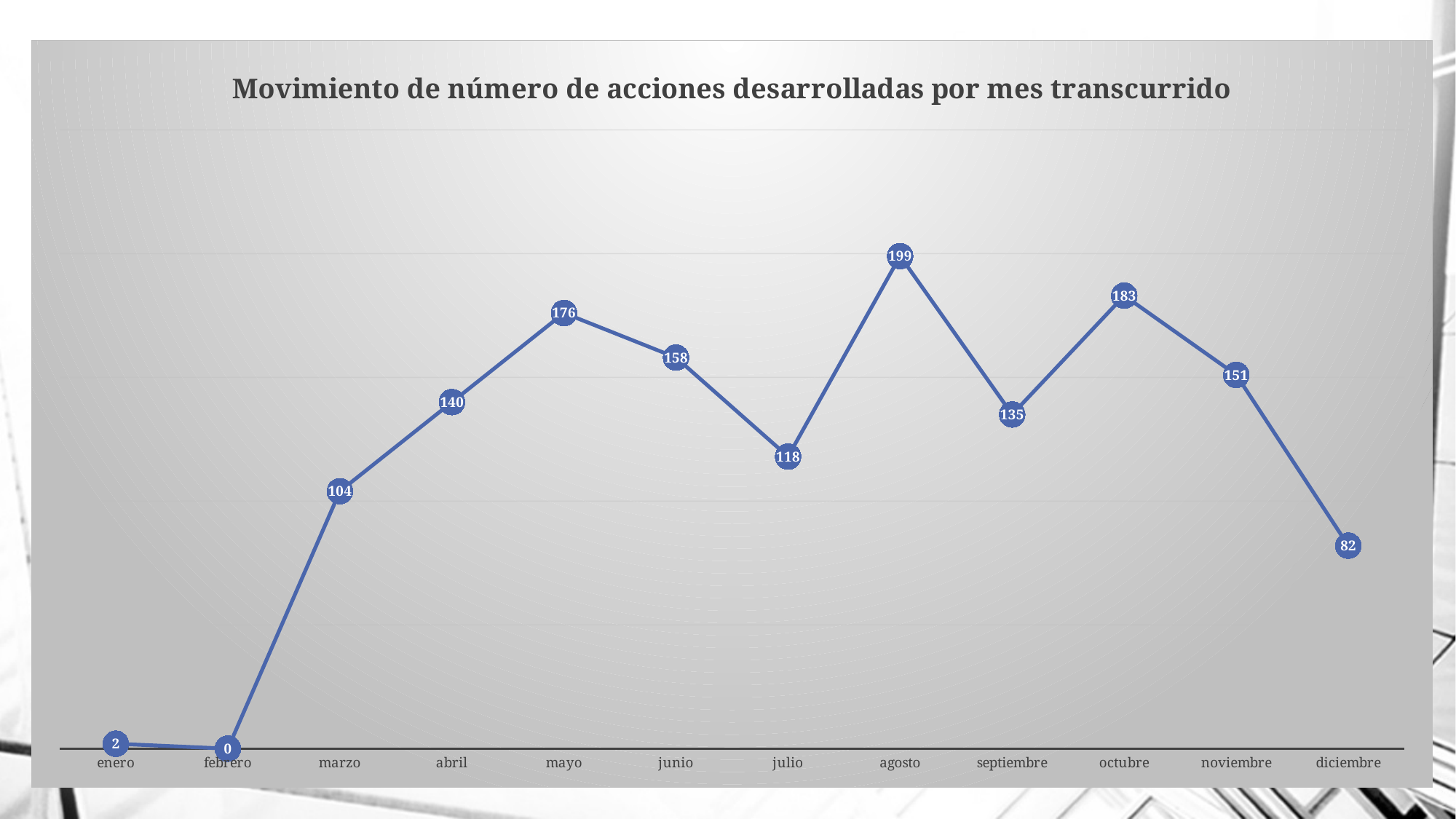
What kind of chart is shown? line chart What is the difference between the values for octubre and noviembre? 32 How many months are plotted on the chart? 12 What is the value for diciembre? 82 What is the title of the chart? Movimiento de número de acciones desarrolladas por mes transcurrido Which month has the lowest value? febrero What is the difference between the values for agosto and julio? 81 Do the values rise or fall from septiembre to octubre? rise What is the value for marzo? 104 Which month has the highest value? agosto Which is larger, the value for mayo or the value for junio? mayo What is the value for agosto? 199